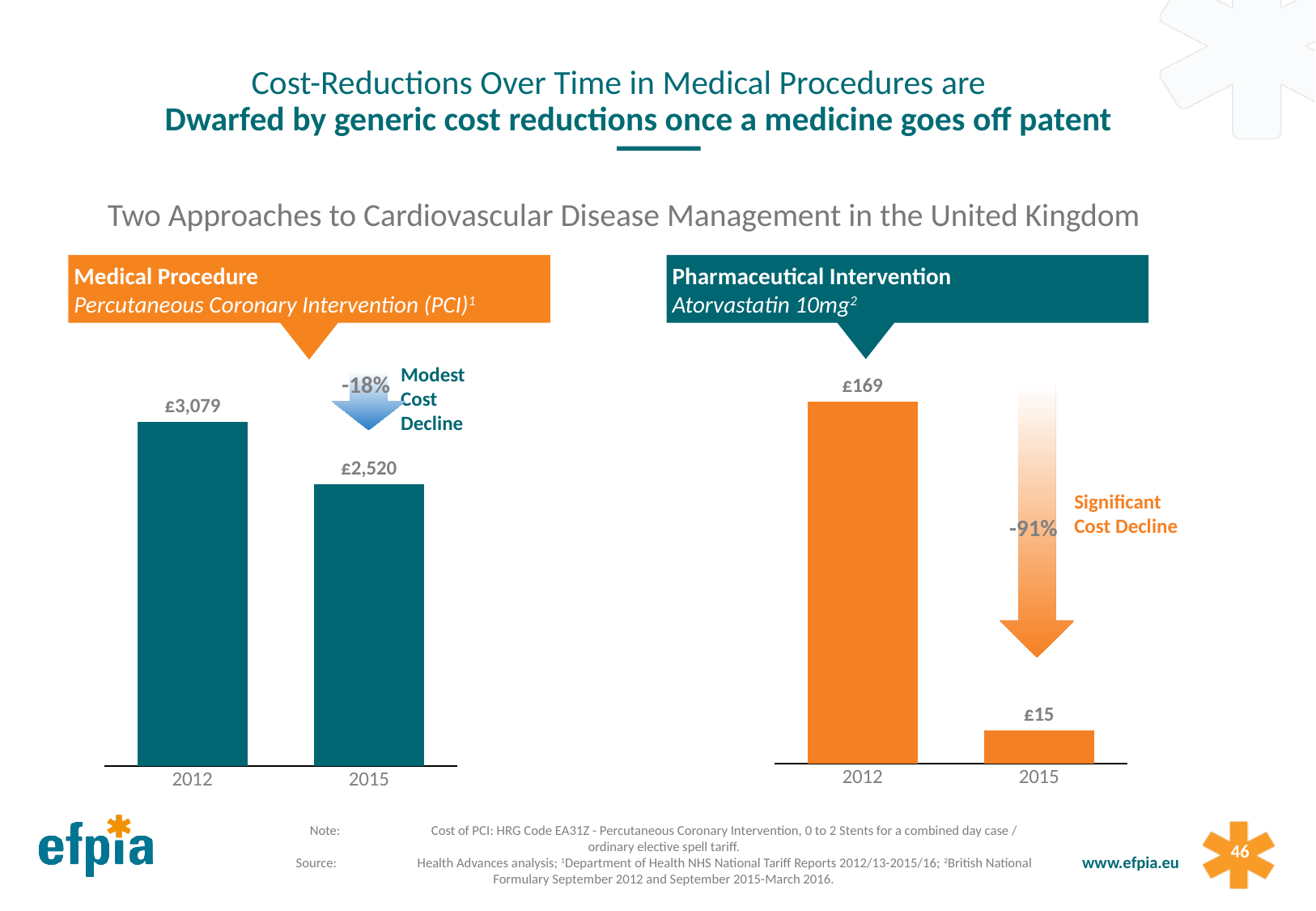
In the Pharmaceutical Intervention (Atorvastatin 10mg) chart, what is the value for 2015? £15 In the Medical Procedure (PCI) chart, what is the value for 2015? £2,520 In the Medical Procedure (PCI) chart, what is the value for 2012? £3,079 In the Medical Procedure (PCI) chart, what is the difference between the 2012 and 2015 values? £559 How many bars are in the Medical Procedure (PCI) chart? 2 What kind of chart is used for the Pharmaceutical Intervention data? bar chart In the Pharmaceutical Intervention (Atorvastatin 10mg) chart, what is the value for 2012? £169 In the Pharmaceutical Intervention chart, what is the difference between the 2012 and 2015 values? £154 What percentage cost decline is shown for the Pharmaceutical Intervention chart? -91% In the Medical Procedure (PCI) chart, which year has the higher value? 2012 In the Pharmaceutical Intervention chart, which year has the lower value? 2015 In the Medical Procedure (PCI) chart, do the values rise or fall from 2012 to 2015? fall